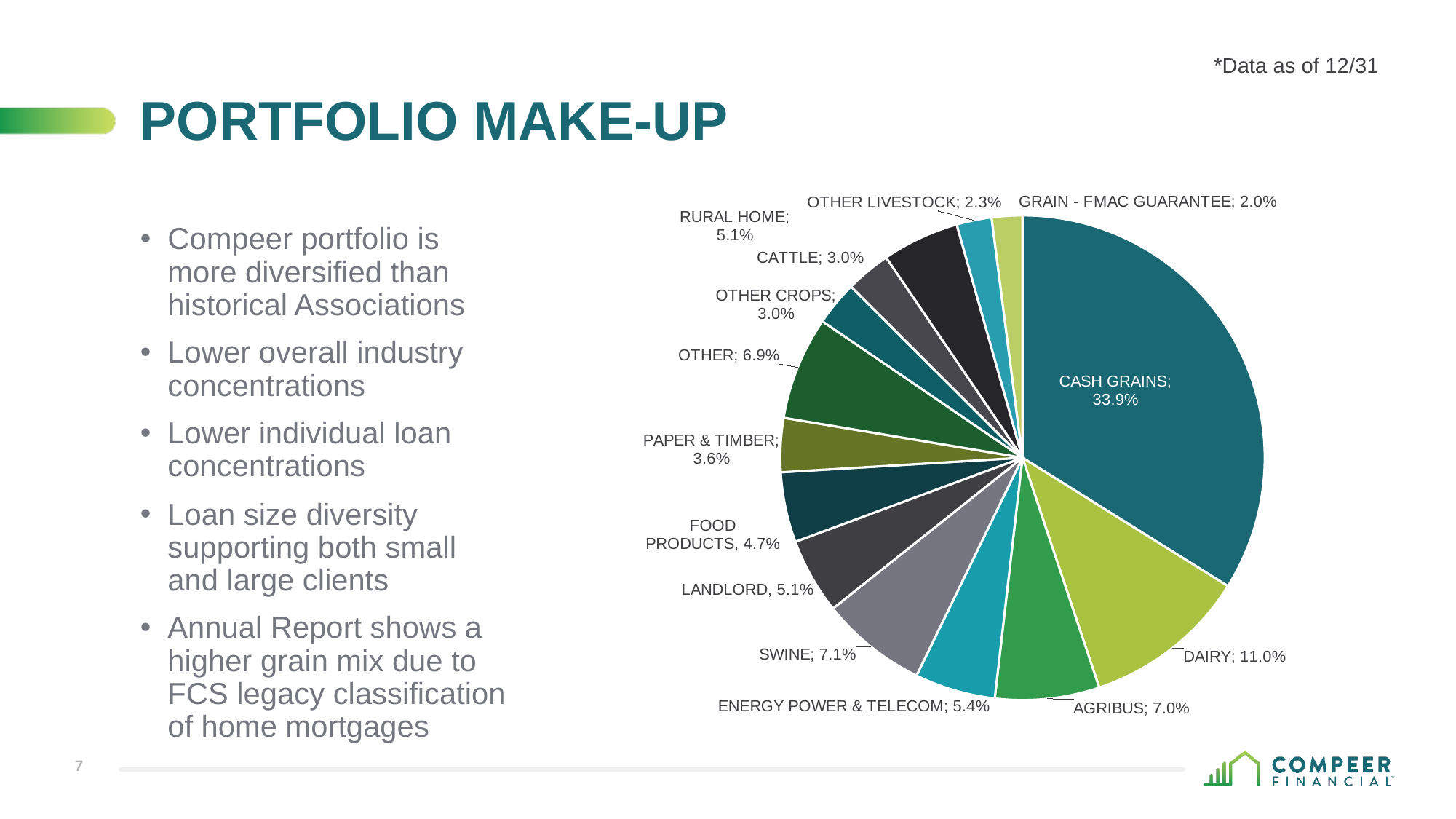
What percentage is shown for ENERGY POWER & TELECOM? 5.4% What share of the portfolio is CASH GRAINS? 33.9% What is the title of the slide containing the pie chart? PORTFOLIO MAKE-UP Which category has the smallest slice of the pie? GRAIN - FMAC GUARANTEE What is the value for PAPER & TIMBER? 3.6% What is the difference in percentage points between DAIRY and AGRIBUS? 4.0 What is the difference in percentage points between CASH GRAINS and DAIRY? 22.9 Which is larger, the share for OTHER or the share for FOOD PRODUCTS? OTHER What kind of chart is shown on the slide? Pie chart How many categories are shown in the pie chart? 14 Which category has the largest slice of the pie? CASH GRAINS What is the value shown for DAIRY? 11.0%